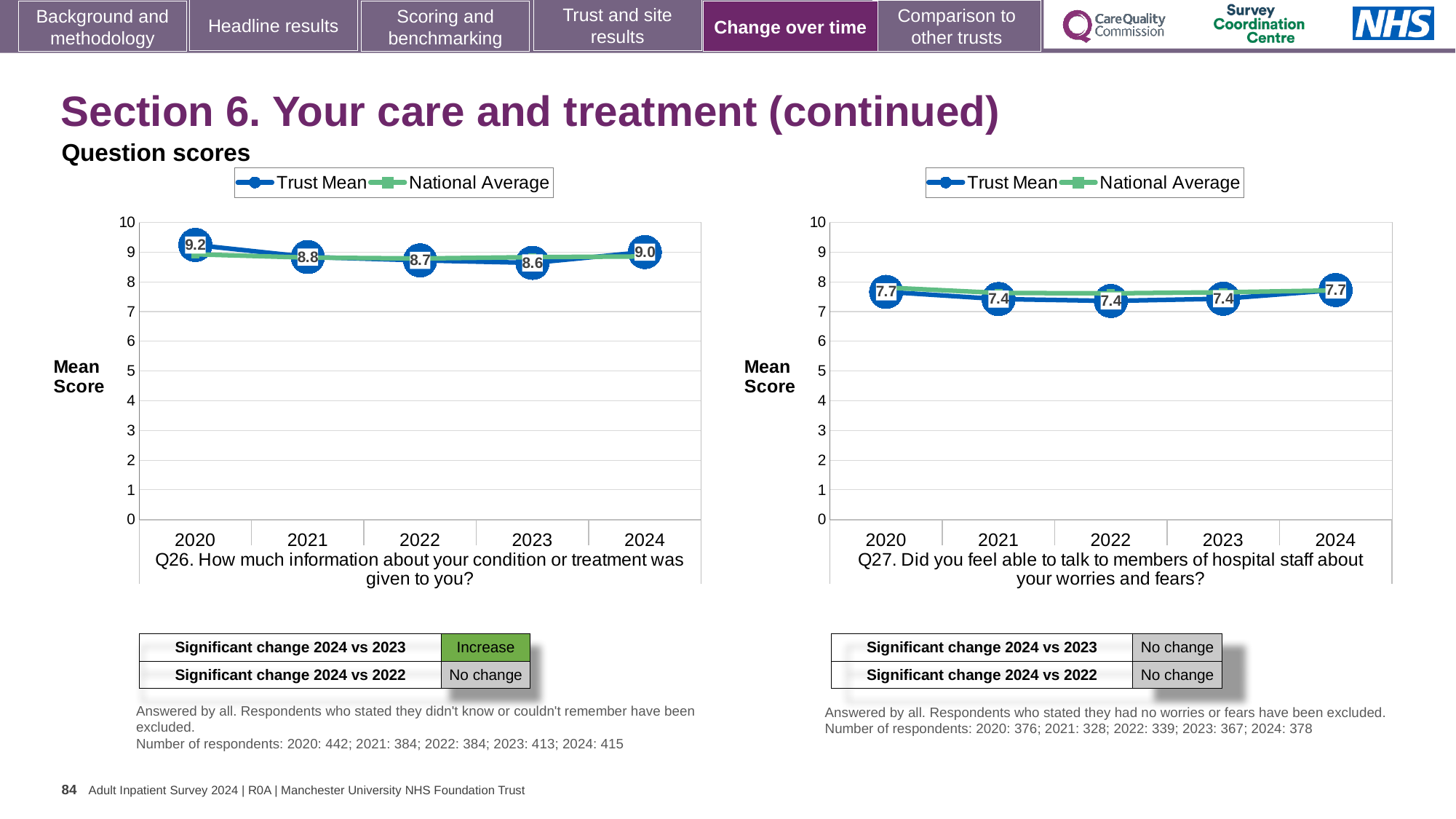
On the Q26 chart, which year has the lowest Trust Mean score? 2023 How many years are shown on the x axis of the Q26 chart? 5 On the Q26 chart, is the Trust Mean score for 2024 greater or less than the score for 2023? greater On the Q26 chart, what is the difference between the Trust Mean scores for 2020 and 2023? 0.6 On the Q27 chart, what is the Trust Mean score for 2021? 7.4 On the Q27 chart, what is the difference between the Trust Mean scores for 2024 and 2023? 0.3 On the Q27 chart, what is the Trust Mean score for 2024? 7.7 On the Q26 chart, what is the Trust Mean score for 2020? 9.2 How many series does the legend of the Q27 chart list? 2 On the Q27 chart, is the Trust Mean score for 2022 greater or less than 8? less What kind of chart is the Q26 chart? Line chart On the Q26 chart, what is the Trust Mean score for 2024? 9.0